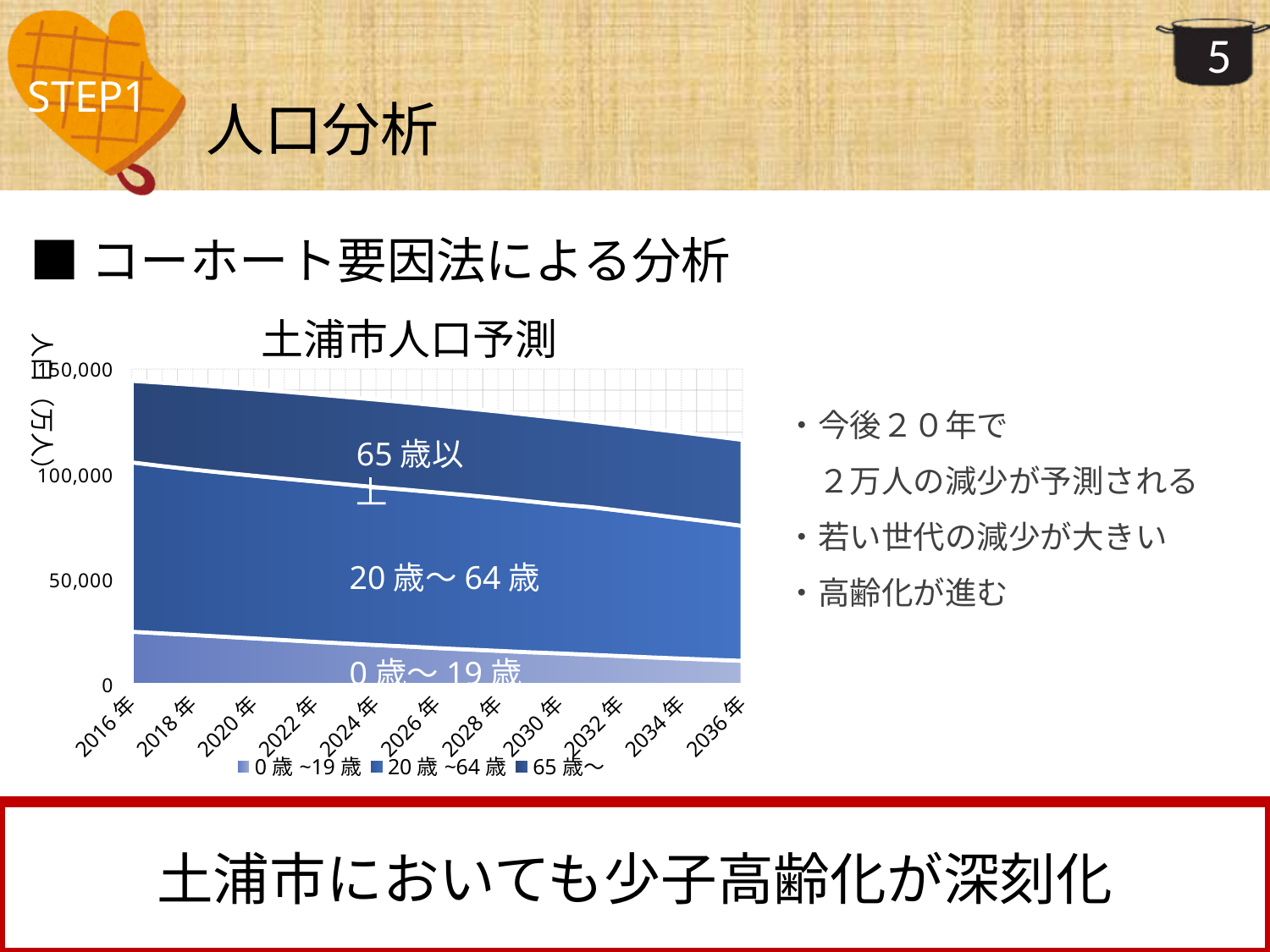
Is the total population for 2036年 in the 土浦市人口予測 chart greater or less than 150,000? less Which age group occupies the smallest band in the 土浦市人口予測 chart? 0歳~19歳 What is the title of the chart on the slide? 土浦市人口予測 Does the 0歳~19歳 band in the 土浦市人口予測 chart get thicker or thinner from 2016年 to 2036年? thinner What is the first year label on the x axis of the 土浦市人口予測 chart? 2016年 Which age group occupies the largest band in the 土浦市人口予測 chart? 20歳~64歳 Is the total population for 2016年 in the 土浦市人口予測 chart greater or less than 100,000? greater Is the value of the 0歳~19歳 band for 2016年 in the 土浦市人口予測 chart greater or less than 50,000? less Does the total population in the 土浦市人口予測 chart rise or fall from 2016年 to 2036年? fall How many series does the legend of the 土浦市人口予測 chart list? 3 What kind of chart is the 土浦市人口予測 chart? stacked area chart How many year labels are shown on the x axis of the 土浦市人口予測 chart? 11